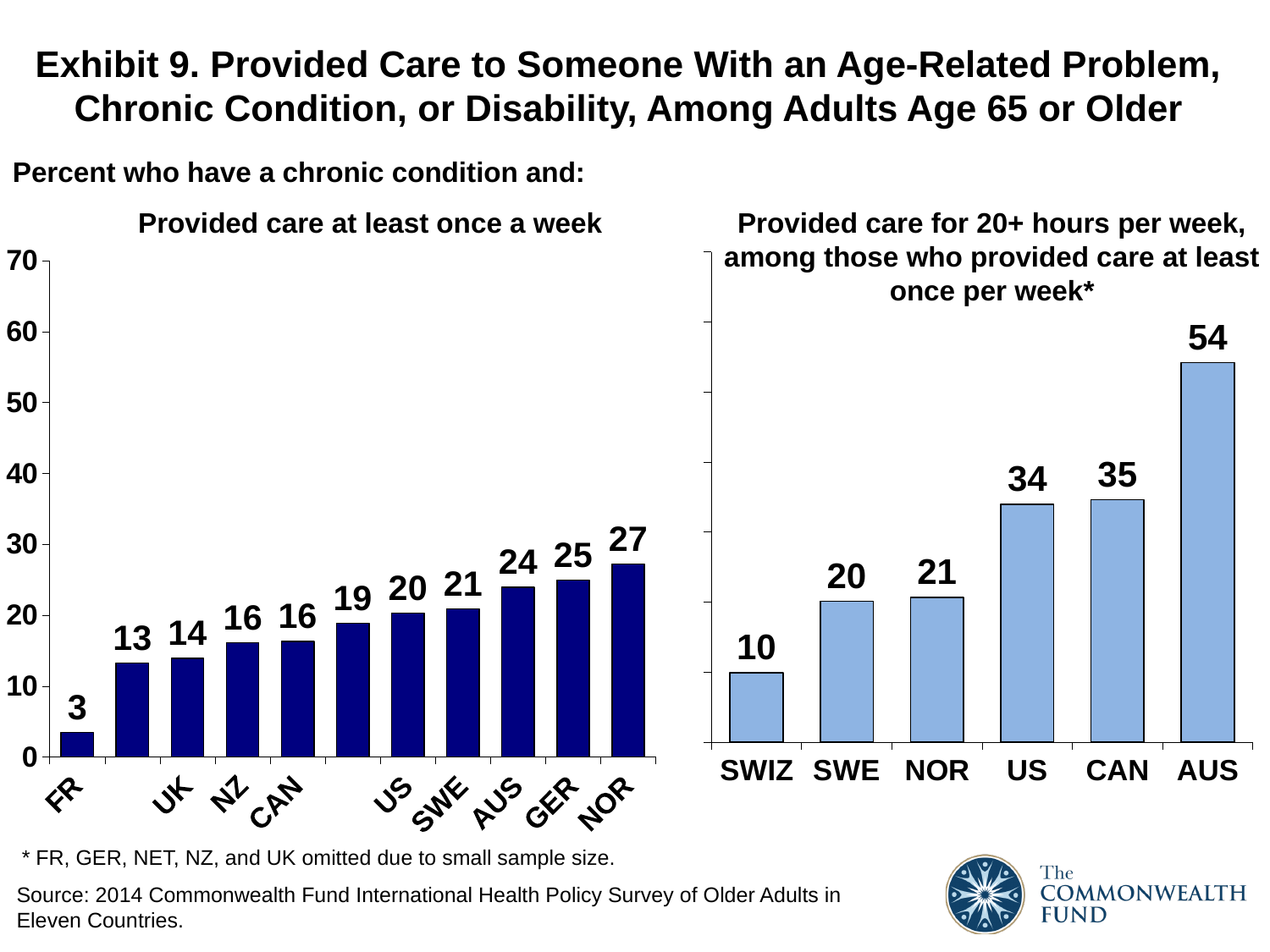
In the 'Provided care for 20+ hours per week' chart, do the values rise or fall from SWIZ to AUS? rise What is the highest value shown on the y axis of the 'Provided care at least once a week' chart? 70 In the 'Provided care at least once a week' chart, which is larger, the value for GER or the value for UK? GER In the 'Provided care at least once a week' chart, which country has the lowest value? FR In the 'Provided care for 20+ hours per week' chart, which country has the highest value? AUS How many bars are shown in the 'Provided care for 20+ hours per week' chart? 6 In the 'Provided care at least once a week' chart, is the value for AUS greater or less than 20? greater In the 'Provided care at least once a week' chart, what is the value for NOR? 27 In the 'Provided care at least once a week' chart, what is the value for FR? 3 In the 'Provided care for 20+ hours per week' chart, what is the difference between the values for AUS and US? 20 In the 'Provided care for 20+ hours per week' chart, what is the value for SWIZ? 10 What kind of chart is the 'Provided care at least once a week' chart? bar chart